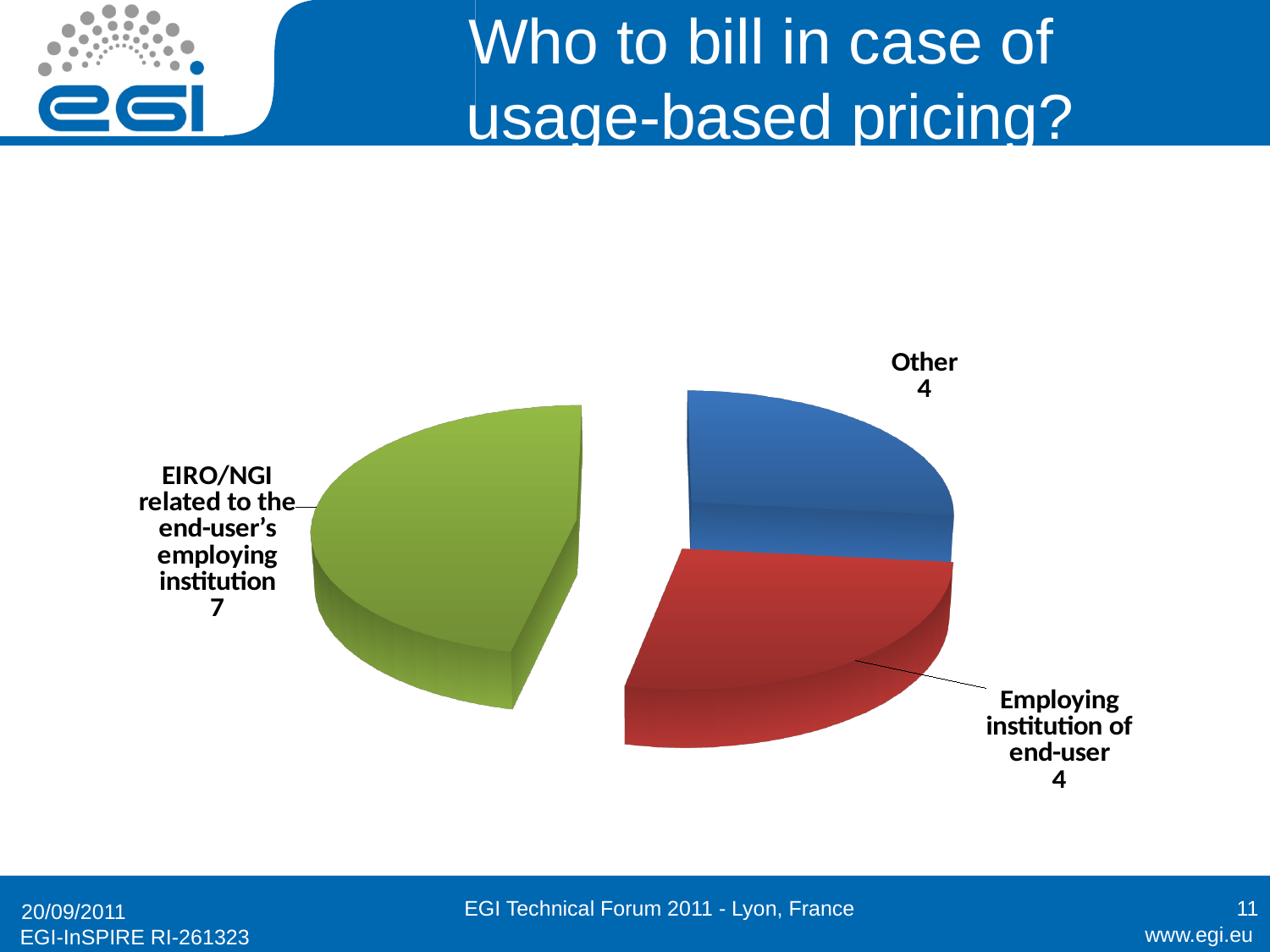
What colour is the 'Other' slice of the pie chart? blue How many slices does the pie chart have? 3 What is the difference between the value for 'EIRO/NGI related to the end-user's employing institution' and the value for 'Employing institution of end-user'? 3 What is the value for the 'Other' slice? 4 What is the total of all the values shown in the pie chart? 15 Which is larger: the value for 'EIRO/NGI related to the end-user's employing institution' or the value for 'Other'? EIRO/NGI related to the end-user's employing institution Which two categories are tied for the smallest value? Other and Employing institution of end-user What is the value for 'Employing institution of end-user'? 4 What is the title of the slide containing the pie chart? Who to bill in case of usage-based pricing? Which category has the largest slice of the pie? EIRO/NGI related to the end-user's employing institution What kind of chart is shown on the slide? pie chart What is the value for 'EIRO/NGI related to the end-user's employing institution'? 7